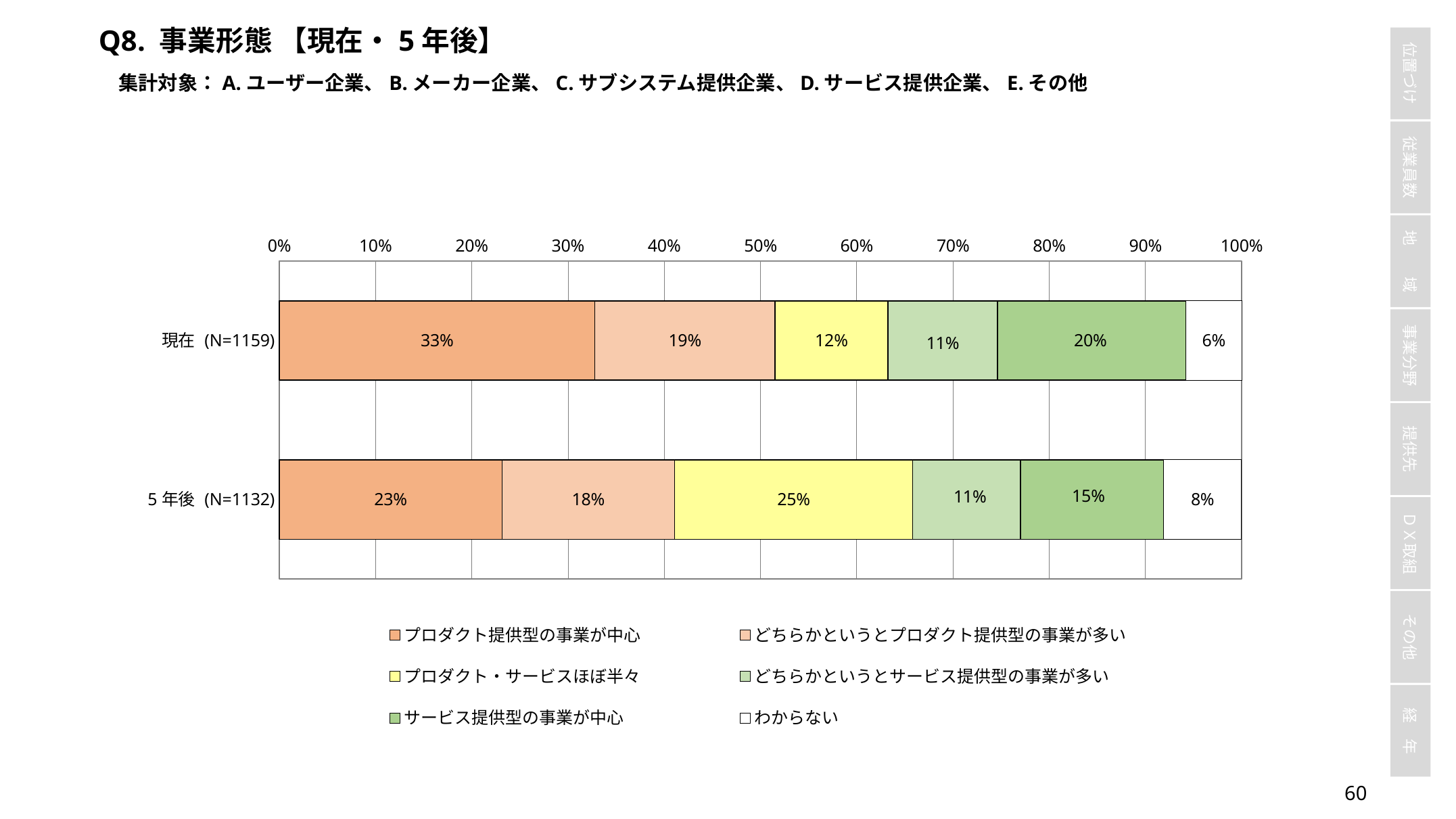
Which is larger: プロダクト・サービスほぼ半々 for 現在 (N=1159) or for 5年後 (N=1132)? 5年後 (N=1132) What is the value for プロダクト・サービスほぼ半々 in the 5年後 (N=1132) bar? 25% What is the value for サービス提供型の事業が中心 in the 現在 (N=1159) bar? 20% How many series does the legend list? 6 What is the value for プロダクト提供型の事業が中心 in the 現在 (N=1159) bar? 33% How many categories (bars) are plotted in the chart? 2 Which segment is the smallest in the 現在 (N=1159) bar? わからない What is the value for わからない in the 5年後 (N=1132) bar? 8% What kind of chart is shown on the slide? Stacked bar chart What is the N value shown for the 5年後 category? N=1132 What is the difference between the プロダクト提供型の事業が中心 values for 現在 (N=1159) and 5年後 (N=1132)? 10 percentage points Which segment is the largest in the 現在 (N=1159) bar? プロダクト提供型の事業が中心